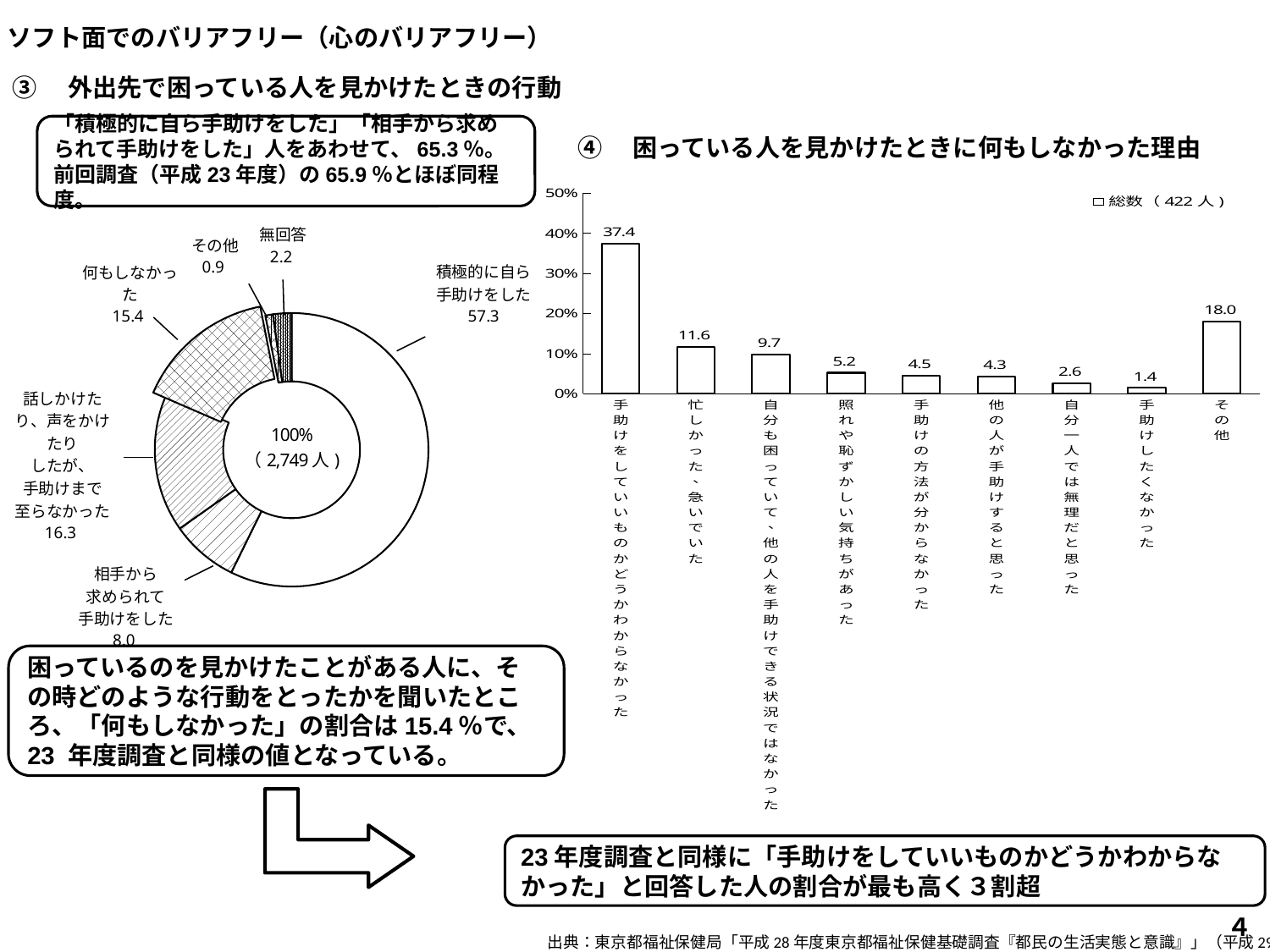
In the bar chart on the right, which is larger: 照れや恥ずかしい気持ちがあった or 自分一人では無理だと思った? 照れや恥ずかしい気持ちがあった In the bar chart on the right, what is the difference between the values for その他 and 自分も困っていて、他の人を手助けできる状況ではなかった? 8.3 In the pie chart on the left, which slice is the smallest? その他 In the bar chart on the right, what is the value for 忙しかった、急いでいた? 11.6 In the bar chart on the right, which category has the lowest value? 手助けしたくなかった In the pie chart on the left, what is the share for 積極的に自ら手助けをした? 57.3 In the bar chart on the right, how many categories are shown on the x axis? 9 In the bar chart on the right (④ 困っている人を見かけたときに何もしなかった理由), what is the value for 手助けをしていいものかどうかわからなかった? 37.4 In the bar chart on the right, which category has the highest value? 手助けをしていいものかどうかわからなかった In the bar chart on the right, what does the legend entry say? 総数 ( 422 人 ) What kind of chart is the chart on the left (③ 外出先で困っている人を見かけたときの行動)? Pie chart (donut) In the pie chart on the left, what is the value for 何もしなかった? 15.4